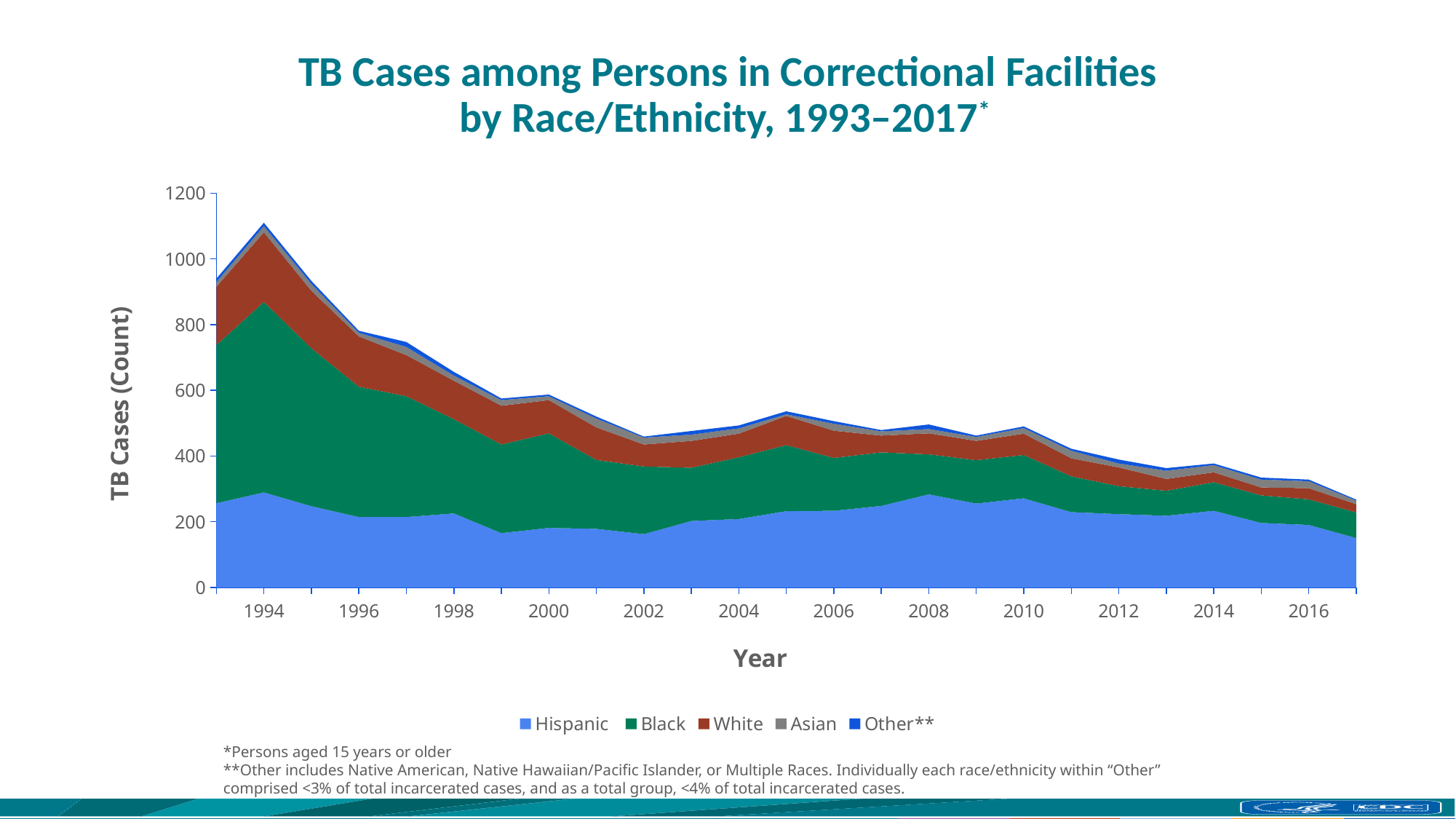
What kind of chart is shown on the slide? stacked area chart Which year has a larger total number of TB cases, 1994 or 2002? 1994 Is the total number of TB cases in 2017 greater or less than 400? less Overall, do total TB cases rise or fall from 1993 to 2017? fall In which year is the total number of TB cases highest? 1994 How many series does the legend list? 5 Is the total number of TB cases in 1994 greater or less than 1000? greater Which race/ethnicity groups are listed in the legend? Hispanic, Black, White, Asian, Other** In which year is the total number of TB cases lowest? 2017 What is the label on the y axis? TB Cases (Count) How many years are plotted along the x axis? 25 Is the number of Hispanic TB cases in 1994 greater or less than 200? greater